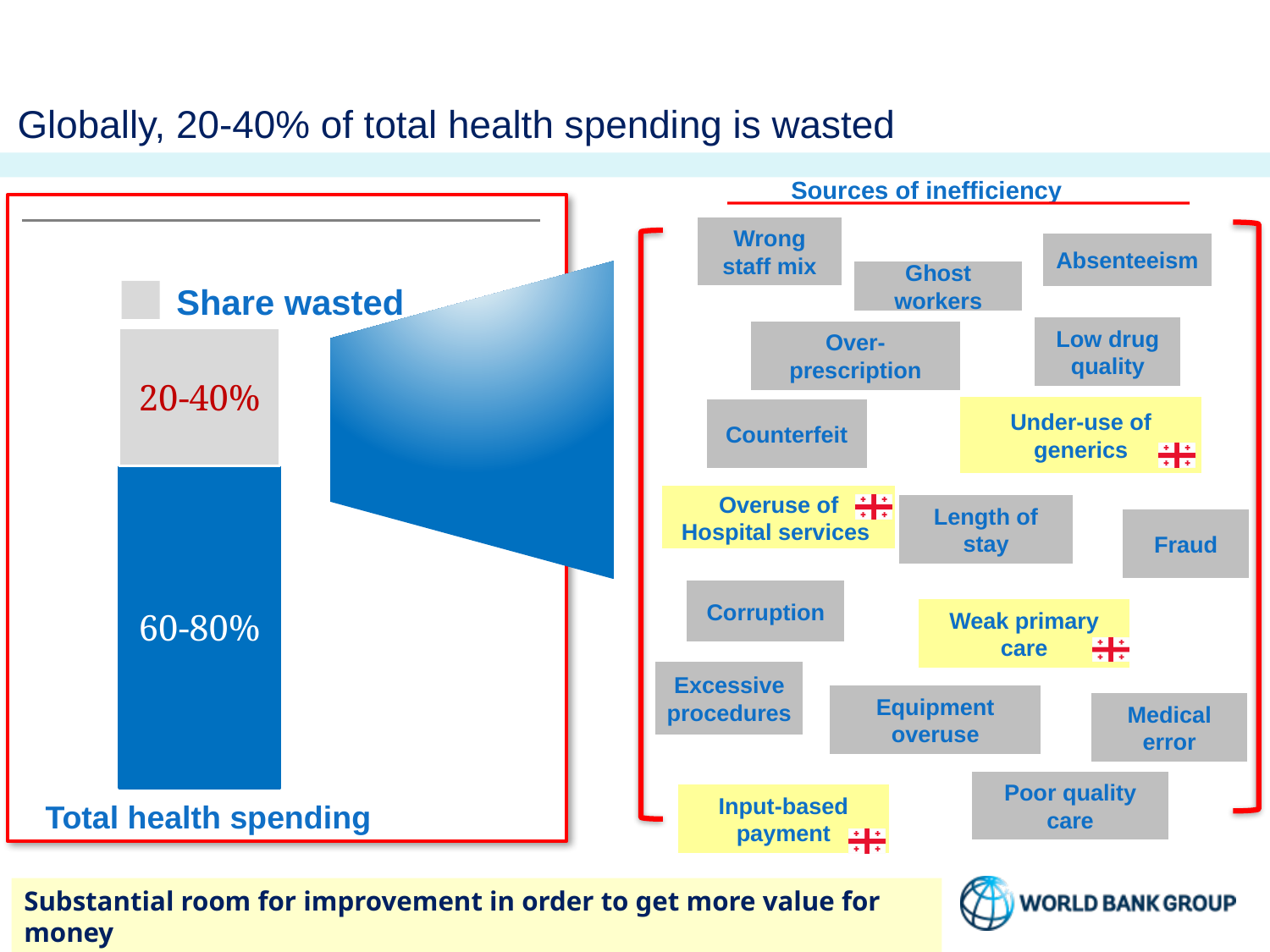
Which segment of the bar is larger, the grey one or the blue one? the blue one What does the grey colour in the bar represent according to the legend? Share wasted According to the chart, what share of total health spending is wasted? 20-40% How many segments does the stacked bar have? 2 What value is printed on the blue segment of the bar? 60-80% Which segment of the bar is the smallest? the grey segment (20-40%) What value is printed on the grey segment of the bar? 20-40% What kind of chart is shown on the left of the slide? bar chart What label appears below the bar? Total health spending Which segment of the bar is the largest? the blue segment (60-80%)